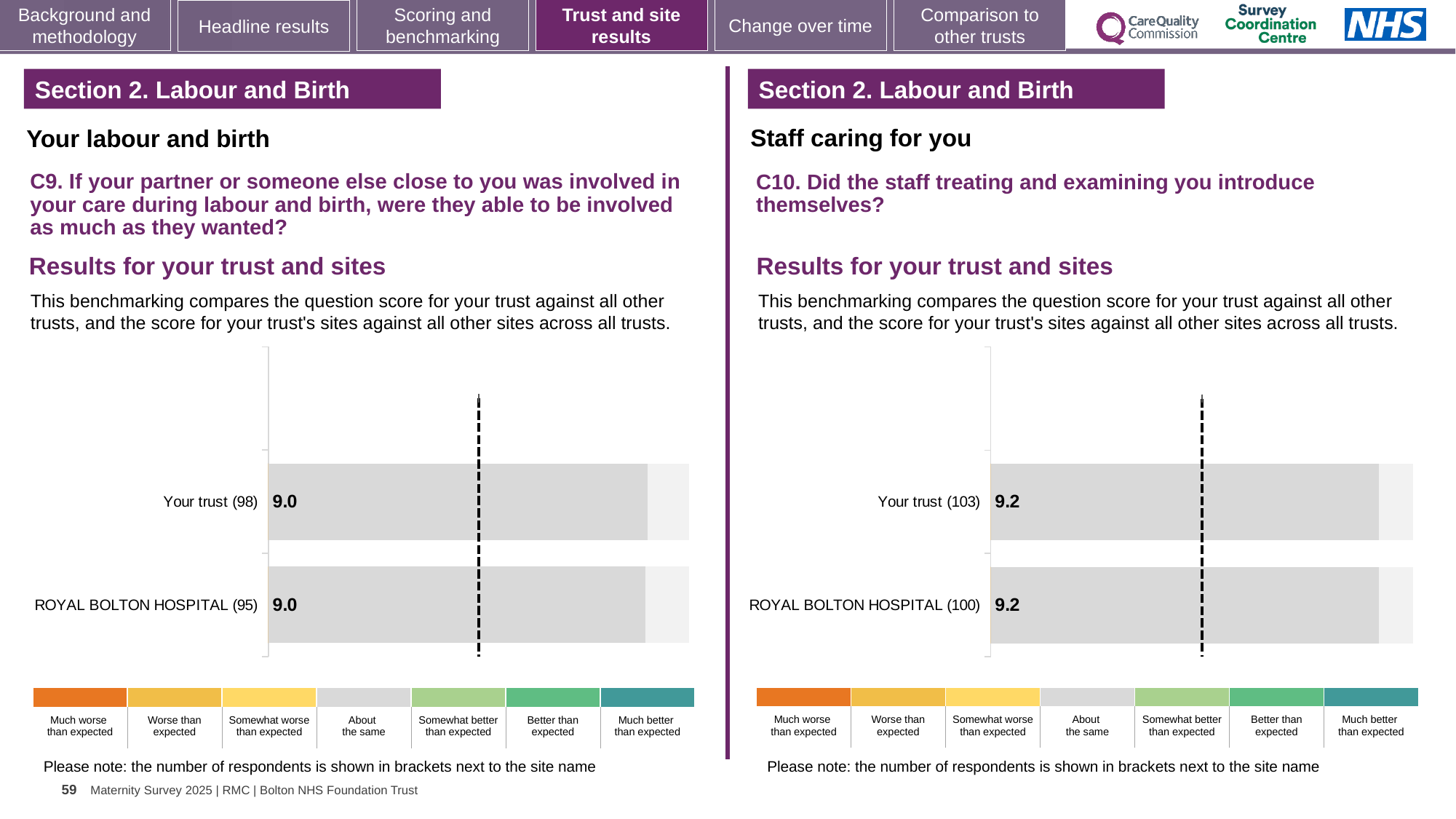
On the right chart (C10), what is the score for ROYAL BOLTON HOSPITAL (100)? 9.2 How many bars are plotted on the left chart (C9)? 2 Is the score for Your trust on the right chart (C10) higher or lower than the score for Your trust on the left chart (C9)? Higher On the left chart (C9), how many respondents are shown in brackets for ROYAL BOLTON HOSPITAL? 95 On the right chart (C10), how many respondents are shown in brackets for Your trust? 103 On the left chart (C9), what is the score for Your trust (98)? 9.0 On the right chart (C10), what is the difference between the score for Your trust and the score for ROYAL BOLTON HOSPITAL? 0.0 What kind of chart is used on the left side of the slide for question C9? Bar chart On the left chart (C9), what is the score for ROYAL BOLTON HOSPITAL (95)? 9.0 How many bars are plotted on the right chart (C10)? 2 On the left chart (C9), what is the difference between the score for Your trust and the score for ROYAL BOLTON HOSPITAL? 0.0 On the right chart (C10), what is the score for Your trust (103)? 9.2